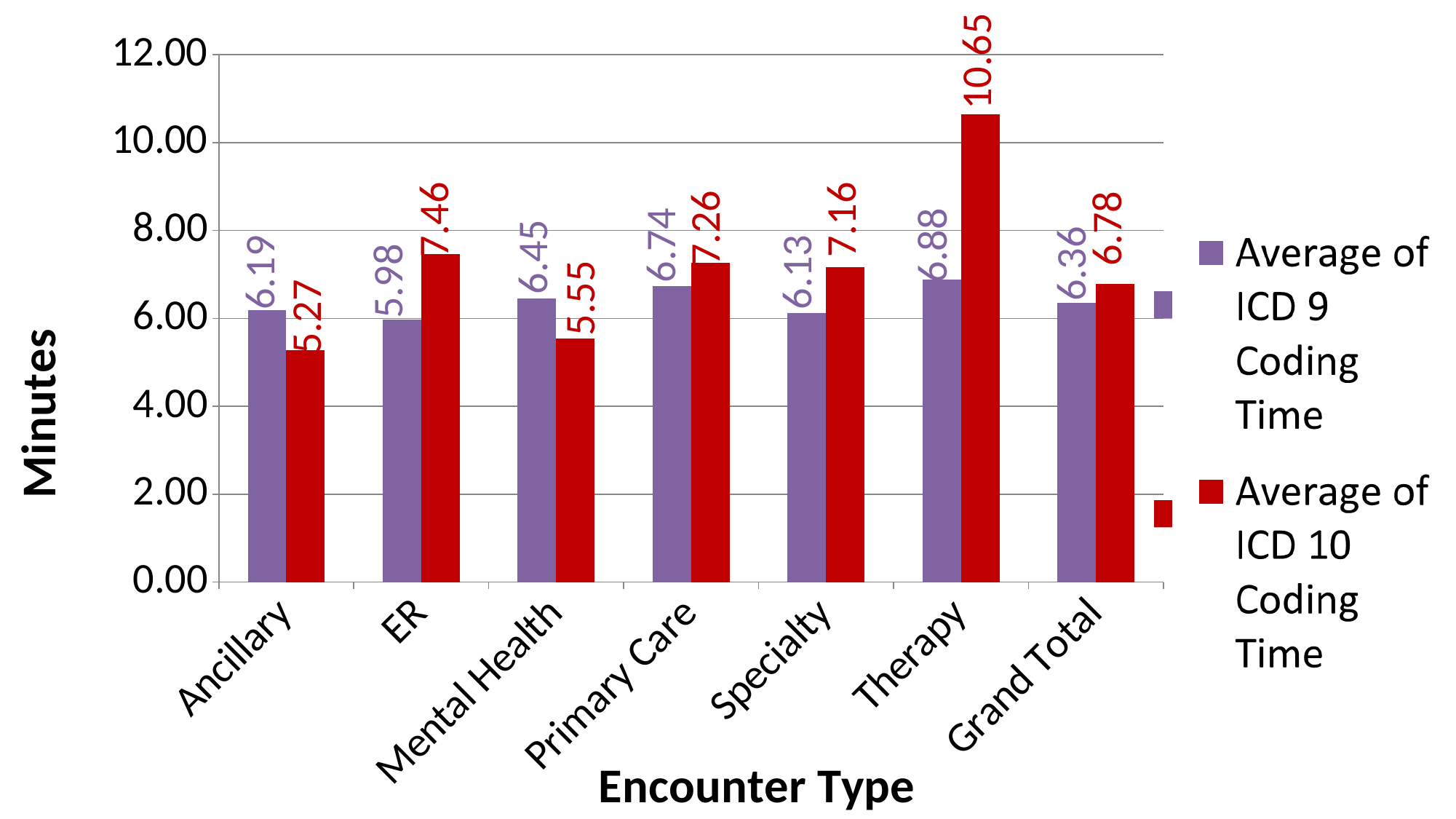
What is the Average of ICD 9 Coding Time for Mental Health? 6.45 How many series does the legend list? 2 For Mental Health, which is larger: the Average of ICD 9 Coding Time or the Average of ICD 10 Coding Time? Average of ICD 9 Coding Time Is the Average of ICD 10 Coding Time for Therapy greater or less than 10.00? greater What is the Average of ICD 10 Coding Time for Ancillary? 5.27 What kind of chart is shown on the slide? bar chart What is the difference between the Average of ICD 10 Coding Time and the Average of ICD 9 Coding Time for Therapy? 3.77 How many encounter types are shown on the x axis? 7 What is the label of the y axis? Minutes Which encounter type has the lowest Average of ICD 9 Coding Time? ER What is the Average of ICD 10 Coding Time for Therapy? 10.65 Which encounter type has the highest Average of ICD 10 Coding Time? Therapy